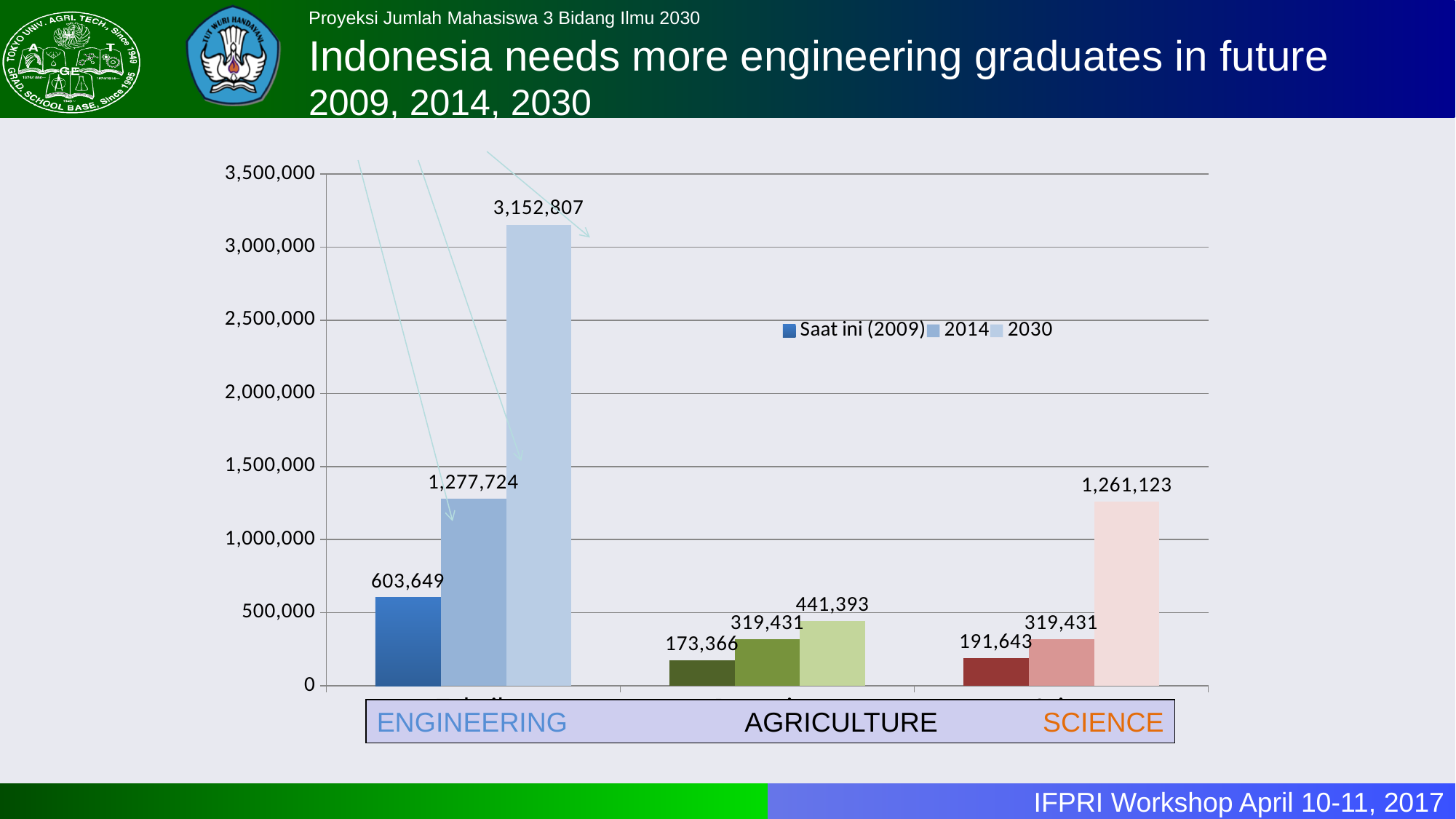
What is the difference between the 2030 and 2009 values for Engineering? 2,549,158 What is the difference between the 2030 values for Science and Agriculture? 819,730 What type of chart is shown on the slide? Bar chart What is the value for Science in 2014? 319,431 How many fields of study are shown on the x axis? 3 Which field has the lowest value in the Saat ini (2009) series? Agriculture What is the value for Agriculture in the Saat ini (2009) series? 173,366 Which is larger, the 2009 value for Science or the 2009 value for Agriculture? Science Which field has the highest value in the 2030 series? Engineering What is the projected number of engineering students in 2030? 3,152,807 What is the value for Engineering in 2014? 1,277,724 How many series does the legend list? 3